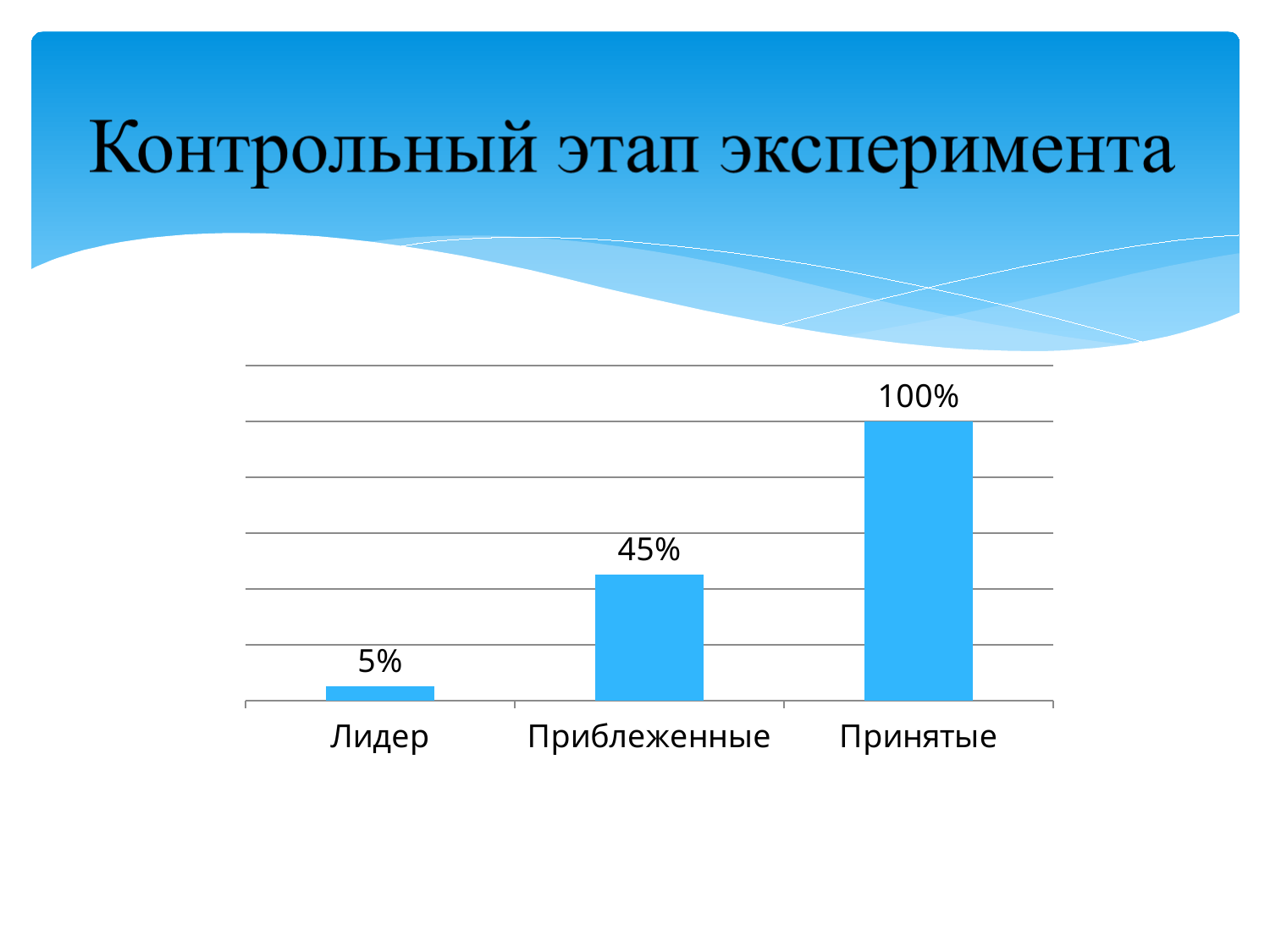
What is the difference between the values for Принятые and Приблеженные? 55% What is the difference between the values for Приблеженные and Лидер? 40% What is the title of the slide containing the chart? Контрольный этап эксперимента How many categories are shown on the x axis? 3 Do the values rise or fall from left to right along the x axis? Rise What is the value for Лидер? 5% Which is larger, the value for Лидер or the value for Приблеженные? Приблеженные What kind of chart is shown on the slide? Bar chart Which category has the highest value? Принятые What is the value for Принятые? 100% Which category has the lowest value? Лидер What is the value for Приблеженные? 45%